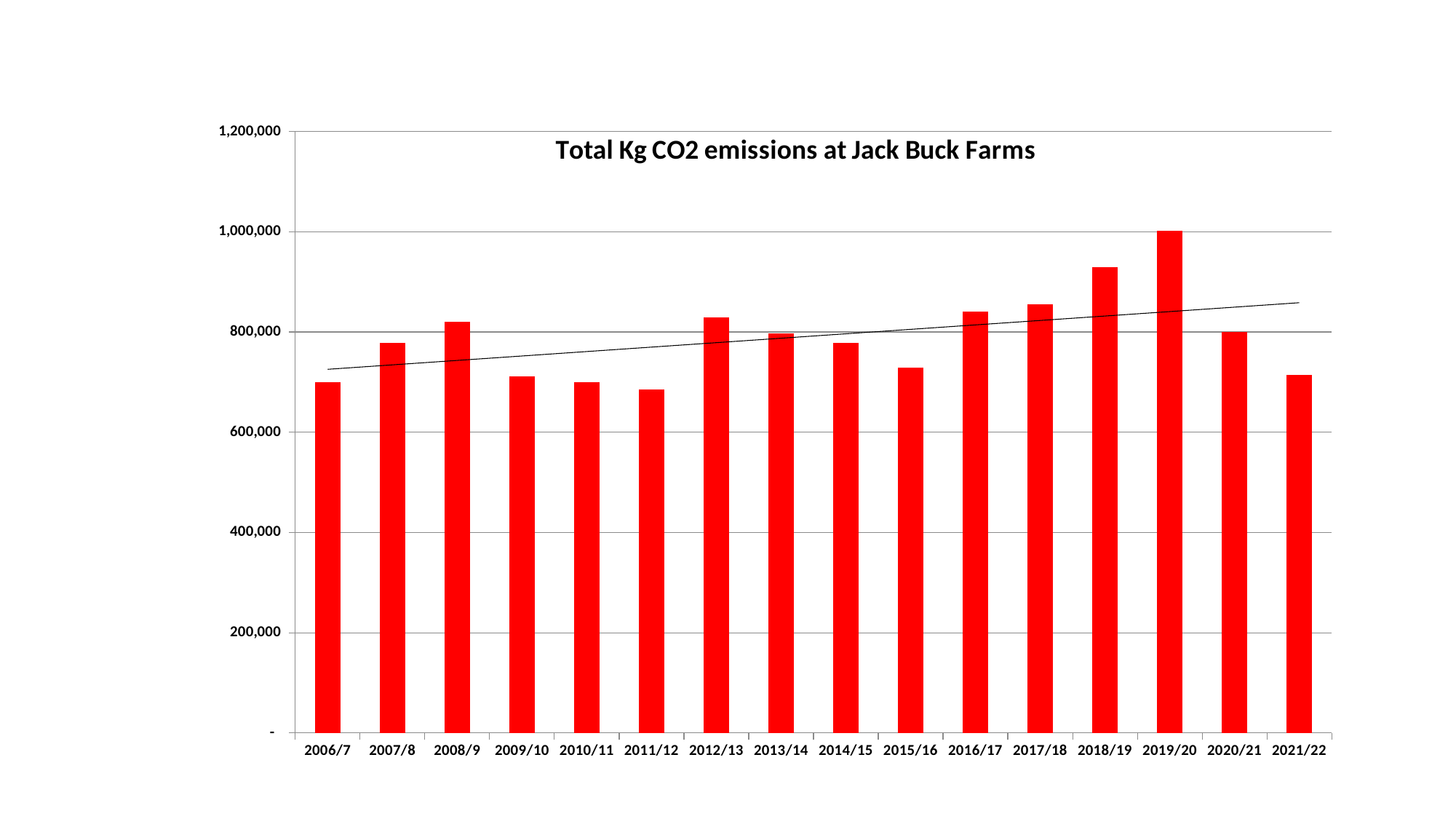
What kind of chart is shown on the slide? bar chart How many years (categories) are plotted on the x axis? 16 Is the value for 2018/19 greater or less than 800,000? greater Which year has the highest total CO2 emissions? 2019/20 Is the value for 2021/22 greater or less than 600,000? greater What colour are the bars in the chart? red Which is larger, the value for 2012/13 or the value for 2015/16? 2012/13 Which year has the lowest total CO2 emissions? 2011/12 Is the value for 2011/12 greater or less than 800,000? less Which is larger, the value for 2018/19 or the value for 2021/22? 2018/19 What is the title of the chart? Total Kg CO2 emissions at Jack Buck Farms